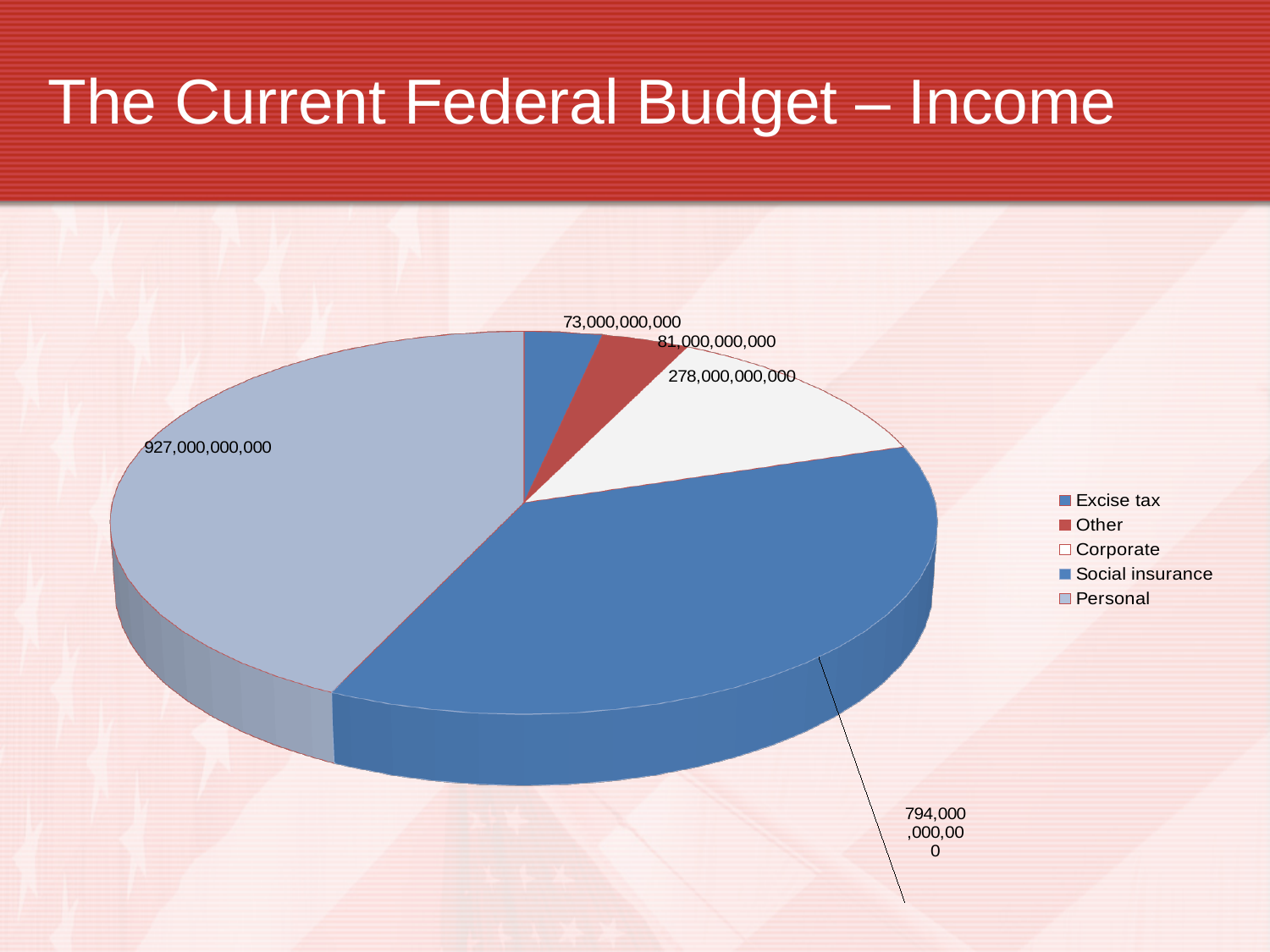
Which category has the largest slice of the pie? Personal What is the value of the Excise tax slice? 73,000,000,000 What type of chart is shown on the slide? Pie chart What is the difference between the Corporate and Other values? 197,000,000,000 What is the difference between the Personal and Social insurance values? 133,000,000,000 Which is larger, the Corporate slice or the Other slice? Corporate What is the title of the slide containing the chart? The Current Federal Budget – Income What is the value of the Social insurance slice? 794,000,000,000 What is the value of the Corporate slice? 278,000,000,000 How many categories does the pie chart have? 5 Which category has the smallest slice of the pie? Excise tax What is the value of the Personal slice? 927,000,000,000